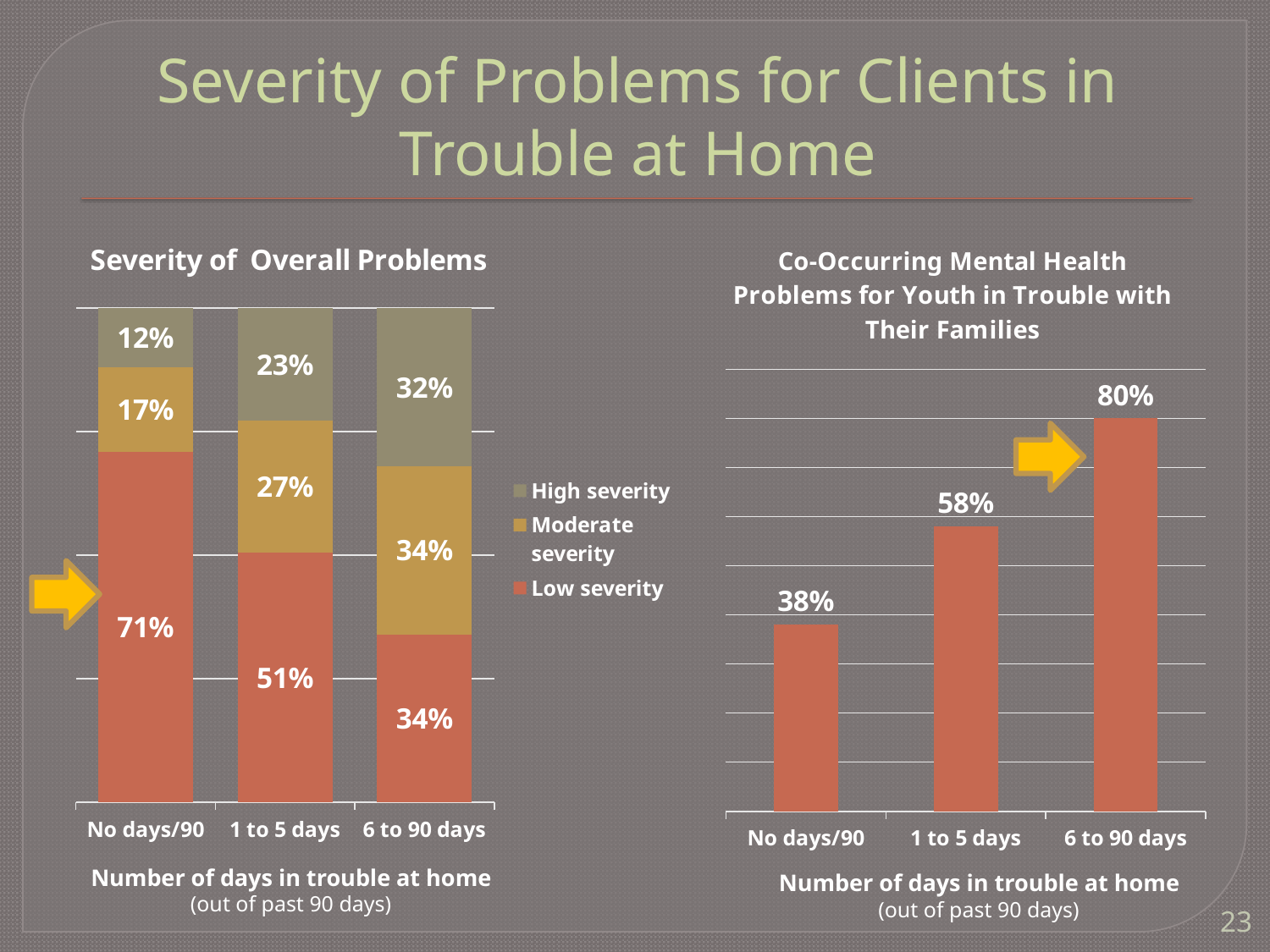
In the 'Severity of Overall Problems' chart, which category has the highest Low severity value? No days/90 In the 'Severity of Overall Problems' chart, what is the Low severity value for 'No days/90'? 71% In the 'Severity of Overall Problems' chart, what is the difference between the High severity values for '6 to 90 days' and 'No days/90'? 20% In the 'Co-Occurring Mental Health Problems for Youth in Trouble with Their Families' chart, do the values rise or fall from 'No days/90' to '6 to 90 days'? rise In the 'Co-Occurring Mental Health Problems for Youth in Trouble with Their Families' chart, what is the value for '1 to 5 days'? 58% In the 'Co-Occurring Mental Health Problems for Youth in Trouble with Their Families' chart, which category has the lowest value? No days/90 In the 'Severity of Overall Problems' chart, what is the High severity value for '6 to 90 days'? 32% In the 'Severity of Overall Problems' chart, what is the total of the stacked bar for '1 to 5 days'? 101% In the 'Co-Occurring Mental Health Problems for Youth in Trouble with Their Families' chart, what is the difference between the values for '6 to 90 days' and 'No days/90'? 42% What kind of chart is the 'Co-Occurring Mental Health Problems for Youth in Trouble with Their Families' chart? bar chart In the 'Severity of Overall Problems' chart, what is the Moderate severity value for '1 to 5 days'? 27% In the 'Severity of Overall Problems' chart, how many series does the legend list? 3